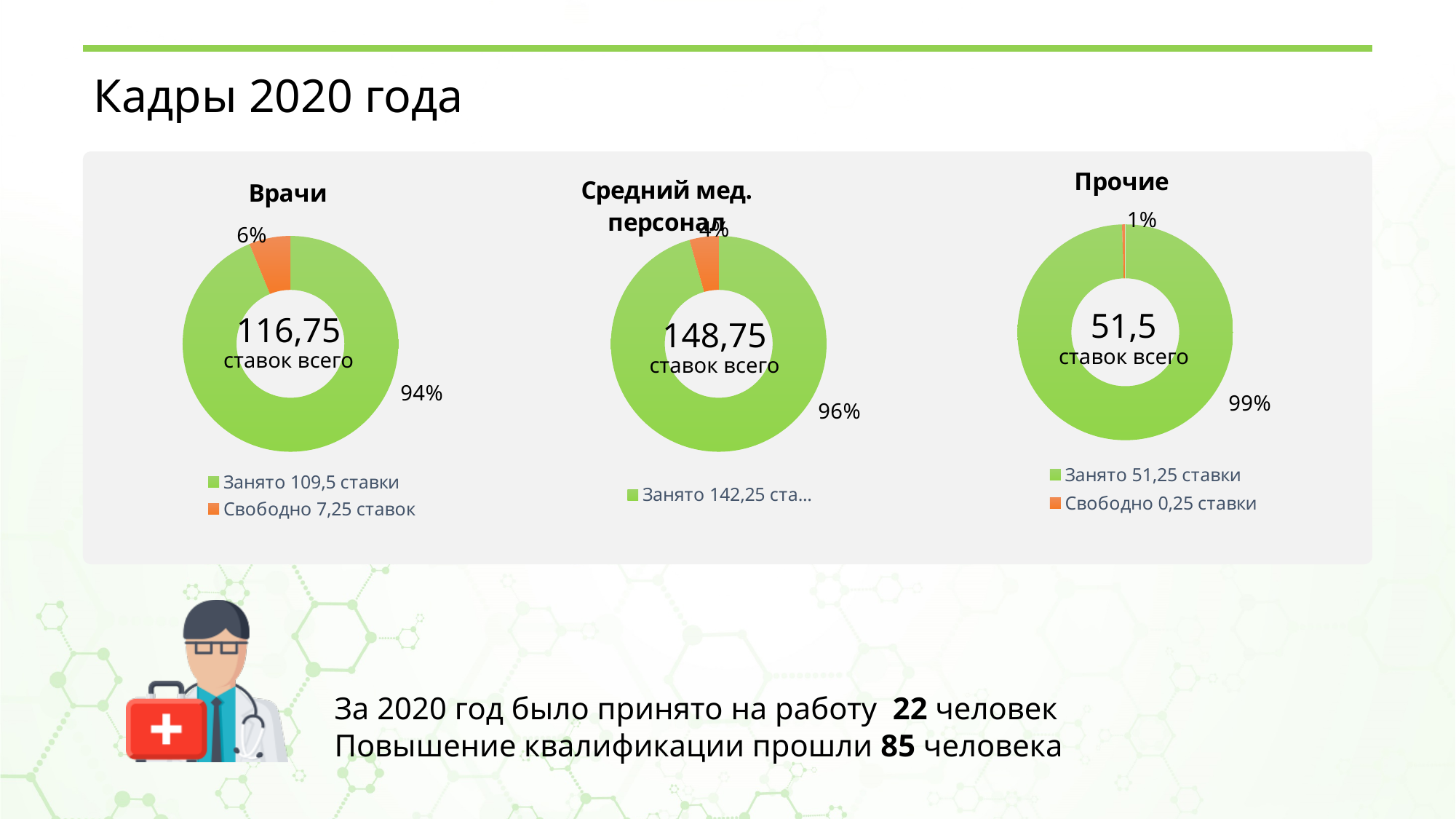
What kind of chart is used for "Врачи"? Doughnut (pie) chart In the "Врачи" chart, what share of positions is shown as occupied (green slice)? 94% How many slices does the "Прочие" chart have? 2 Which of the three charts shows the largest share of free positions? Врачи In the "Врачи" chart, what share of positions is shown as free (orange slice)? 6% What total number of positions (ставок всего) is shown in the centre of the "Средний мед. персонал" chart? 148,75 What total number of positions (ставок всего) is shown in the centre of the "Прочие" chart? 51,5 What total number of positions (ставок всего) is shown in the centre of the "Врачи" chart? 116,75 According to the legend of the "Врачи" chart, how many positions are free (Свободно)? 7,25 ставок In the "Средний мед. персонал" chart, what share is shown for the green slice? 96% According to the legend of the "Прочие" chart, how many positions are occupied (Занято)? 51,25 ставки